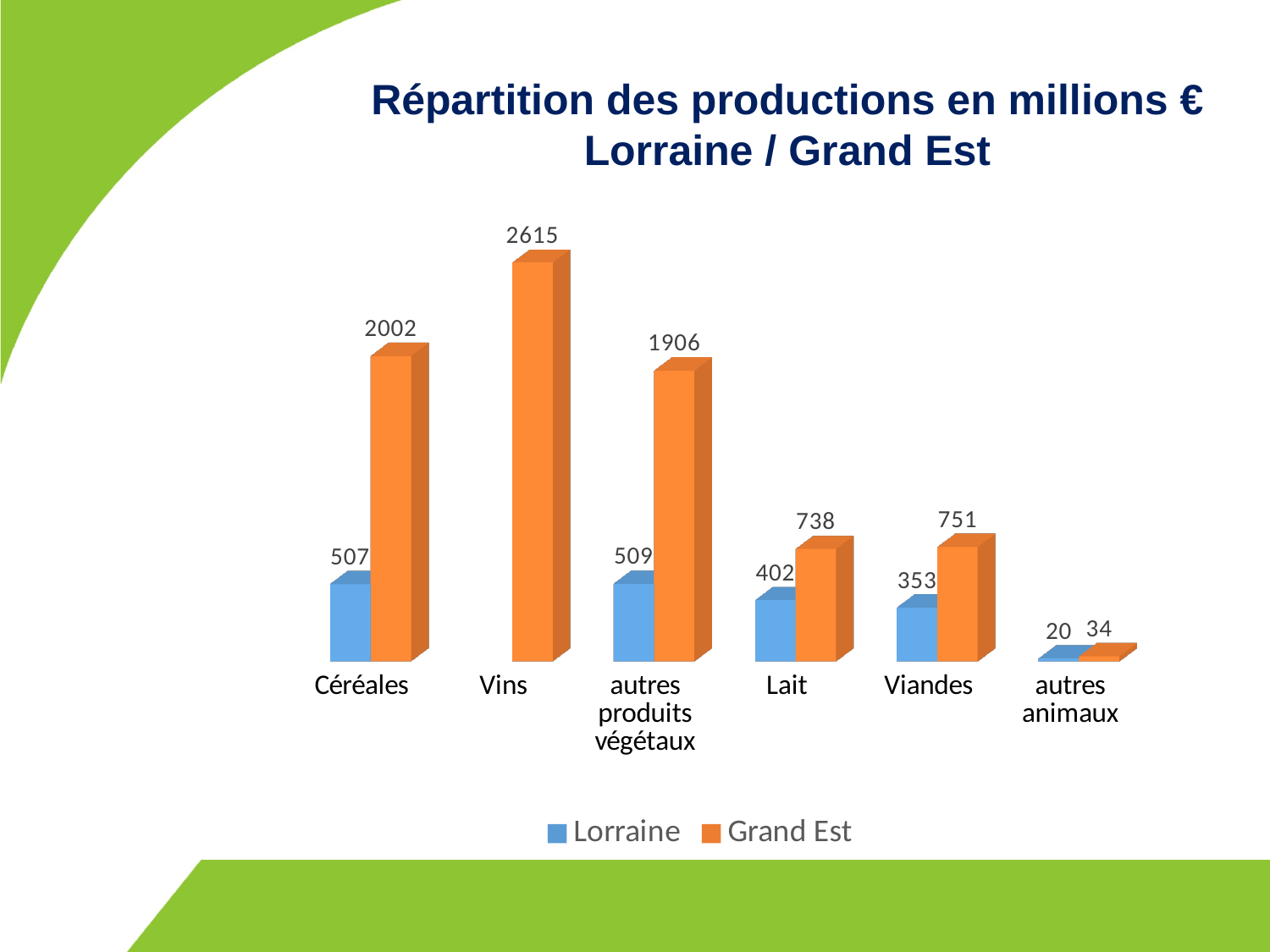
How many categories are shown on the x axis? 6 What is the Lorraine value for Céréales? 507 How many series does the legend list? 2 What is the Lorraine value for autres animaux? 20 Which category has the highest Grand Est value? Vins Which is larger, the Grand Est value for Viandes or the Grand Est value for Lait? Grand Est value for Viandes Which category has the lowest Lorraine value? autres animaux Which colour represents the Grand Est series? orange What kind of chart is shown on the slide? bar chart What is the Grand Est value for Vins? 2615 What is the Grand Est value for Lait? 738 What is the difference between the Grand Est and Lorraine values for Céréales? 1495